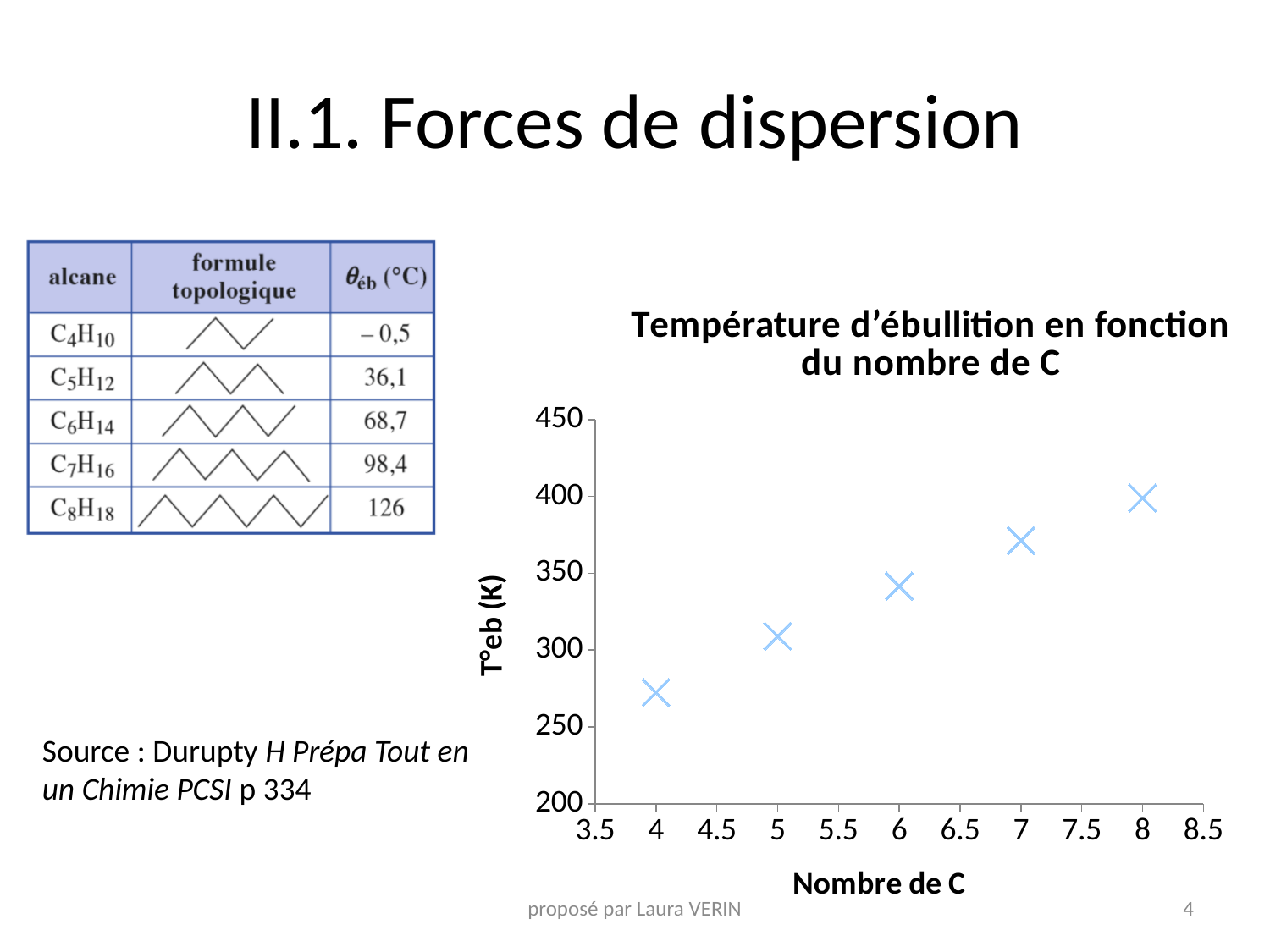
At which number of C is the boiling temperature highest? 8 Is the boiling temperature for 4 carbon atoms greater or less than 300 K? less Do the boiling temperatures rise or fall as the number of carbon atoms increases along the x axis? rise At which number of C is the boiling temperature lowest? 4 Is the boiling temperature for 5 carbon atoms greater or less than 350 K? less What is the label of the y axis of the chart? T°eb (K) What is the title of the chart? Température d'ébullition en fonction du nombre de C What kind of chart is shown on the slide? scatter chart Which has a higher boiling temperature: 7 carbon atoms or 5 carbon atoms? 7 carbon atoms Is the boiling temperature for 6 carbon atoms greater or less than 300 K? greater How many data points are plotted in the chart? 5